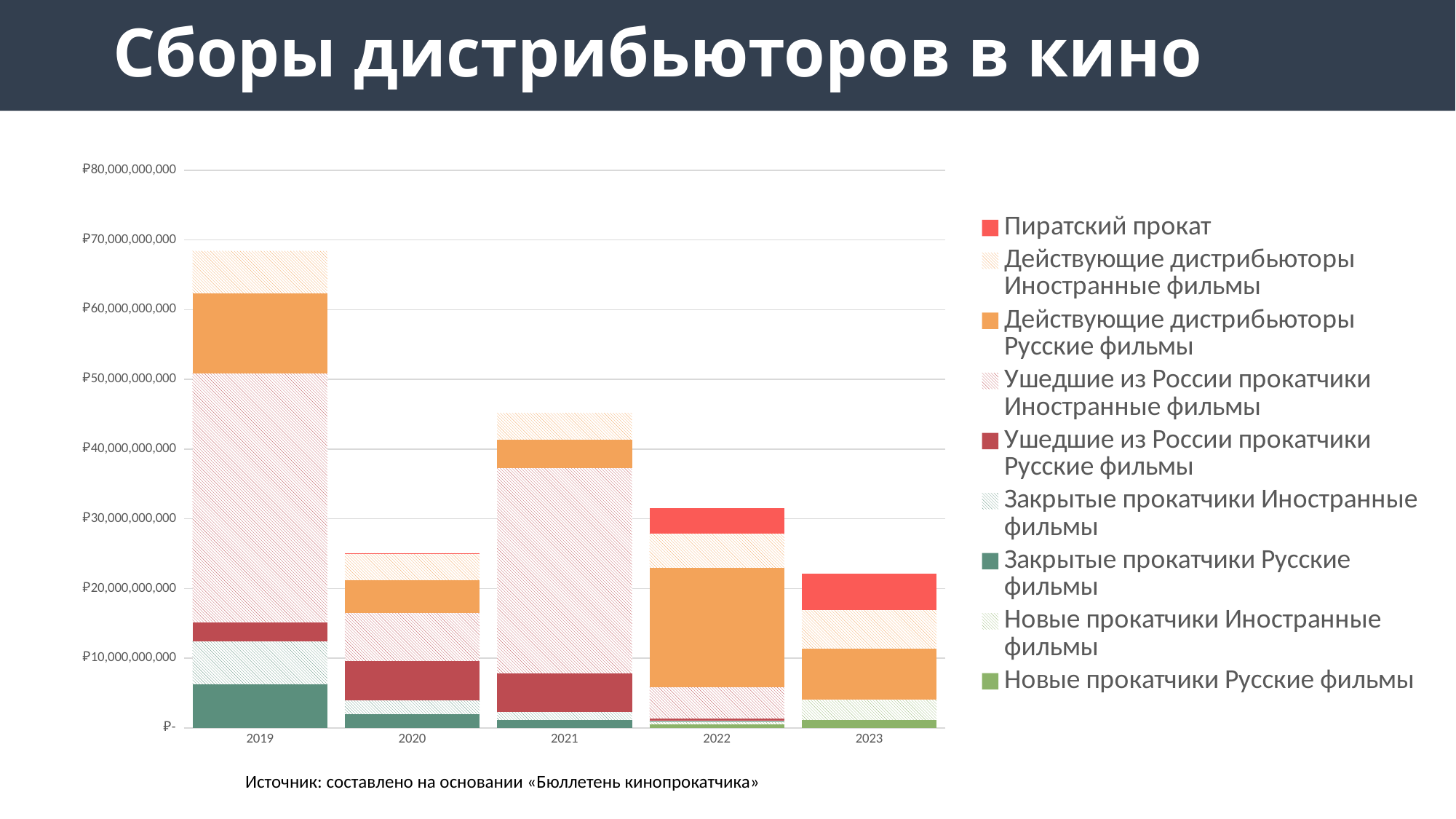
Is the total for 2022 greater or less than ₽40,000,000,000? less Is the total for 2021 greater or less than ₽40,000,000,000? greater Is the total for 2019 greater or less than ₽60,000,000,000? greater How many series does the chart legend list? 9 How many years are shown on the x axis of the chart? 5 Does the total bar rise or fall from 2019 to 2020? Fall Which year has the larger total bar, 2019 or 2021? 2019 Which year has the highest total bar? 2019 What is the title of the slide? Сборы дистрибьюторов в кино What kind of chart is shown on the slide? Stacked bar chart